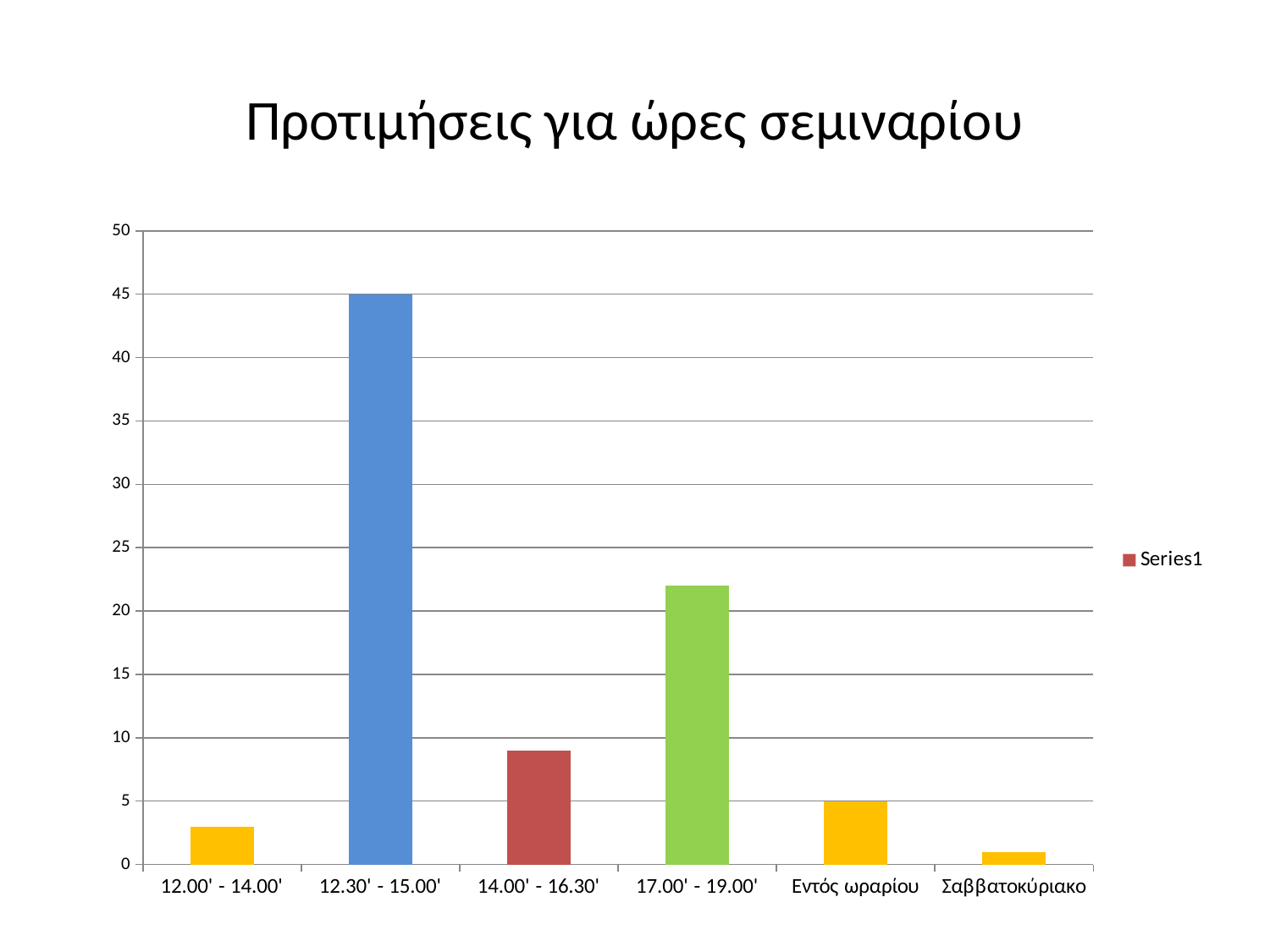
Is the value for 12.00' - 14.00' greater or less than 5? less Which is larger, the value for 17.00' - 19.00' or the value for 14.00' - 16.30'? 17.00' - 19.00' Is the value for 17.00' - 19.00' greater or less than 20? greater What is the difference between the values for 12.30' - 15.00' and Εντός ωραρίου? 40 What is the value for 12.30' - 15.00'? 45 What is the title of the chart? Προτιμήσεις για ώρες σεμιναρίου Which category has the lowest value? Σαββατοκύριακο How many series does the legend list? 1 What type of chart is shown on the slide? bar chart How many categories are shown on the x axis? 6 What is the value for Εντός ωραρίου? 5 Which category has the highest value? 12.30' - 15.00'